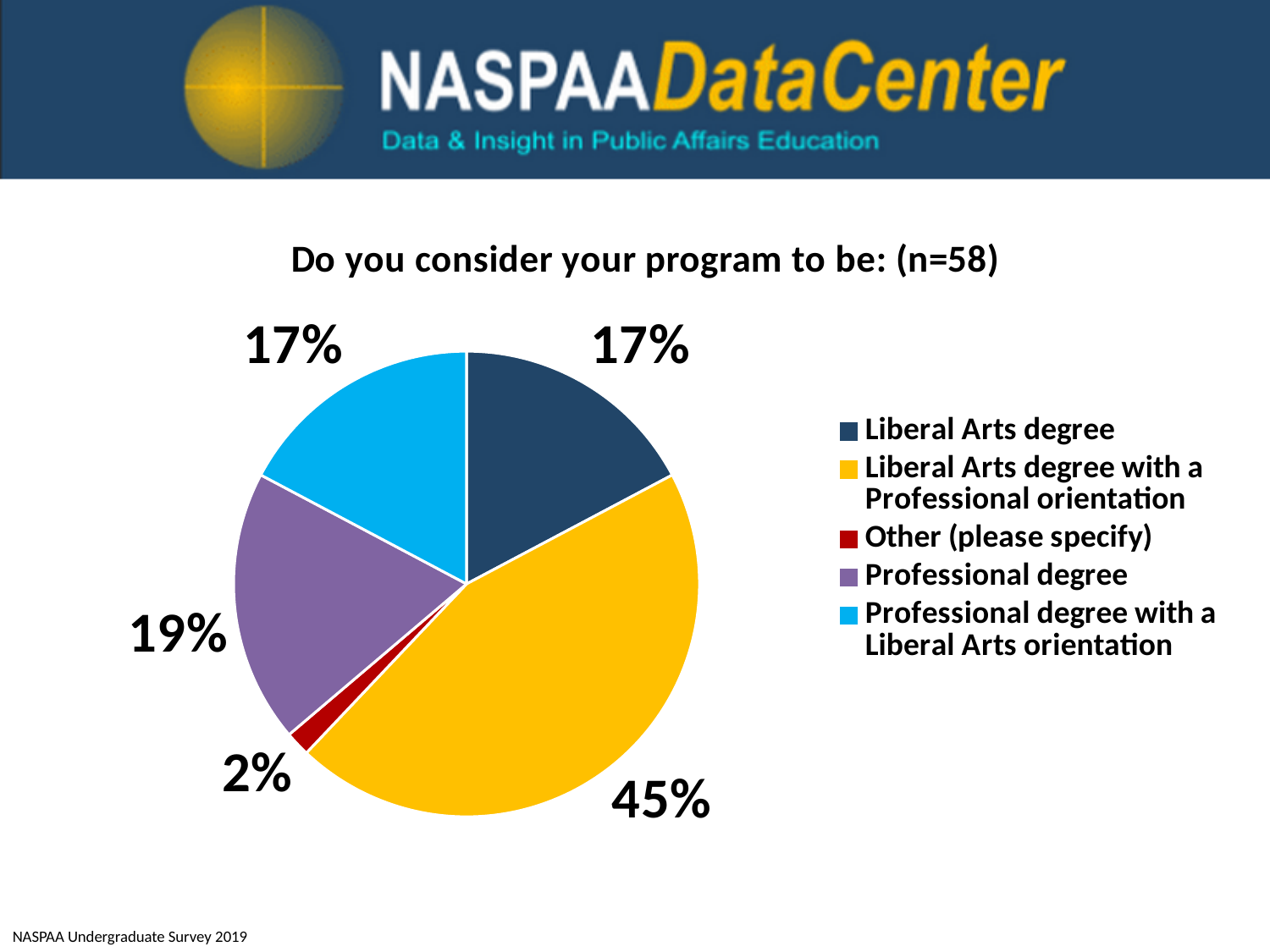
Which category has the smallest share of the pie? Other (please specify) What kind of chart is shown on the slide? Pie chart What percentage of programs are a Liberal Arts degree? 17% What percentage of programs answered Other (please specify)? 2% What is the title of the chart? Do you consider your program to be: (n=58) What percentage of programs are a Liberal Arts degree with a Professional orientation? 45% What is the difference in percentage points between Liberal Arts degree with a Professional orientation and Professional degree? 26 Which category has the largest share of the pie? Liberal Arts degree with a Professional orientation Which is larger: the share for Professional degree or the share for Liberal Arts degree? Professional degree What percentage of programs are a Professional degree? 19% What colour is the slice for Professional degree with a Liberal Arts orientation? Light blue How many categories does the legend list? 5